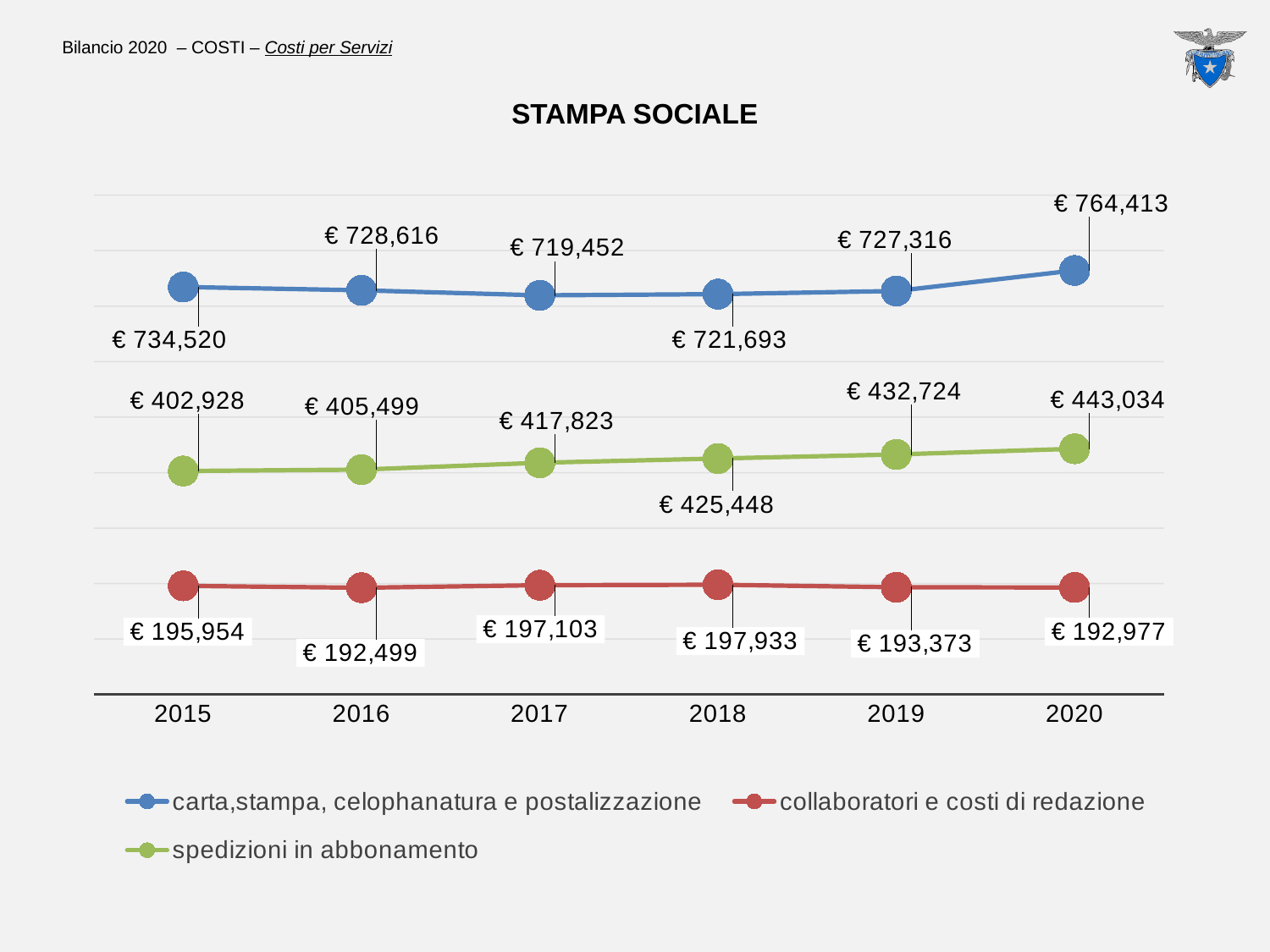
What is the title of the chart? STAMPA SOCIALE What is the value for 'carta,stampa, celophanatura e postalizzazione' in 2020? € 764,413 In which year is 'collaboratori e costi di redazione' highest? 2018 What is the difference between the 2020 and 2019 values for 'carta,stampa, celophanatura e postalizzazione'? € 37,097 What is the value for 'collaboratori e costi di redazione' in 2016? € 192,499 What is the value for 'spedizioni in abbonamento' in 2017? € 417,823 Which is larger in 2018: 'spedizioni in abbonamento' or 'collaboratori e costi di redazione'? spedizioni in abbonamento How many years are shown on the x axis? 6 Does 'spedizioni in abbonamento' rise or fall from 2015 to 2020? rise What type of chart is shown on the slide? line chart In which year is 'carta,stampa, celophanatura e postalizzazione' lowest? 2017 How many series does the legend list? 3